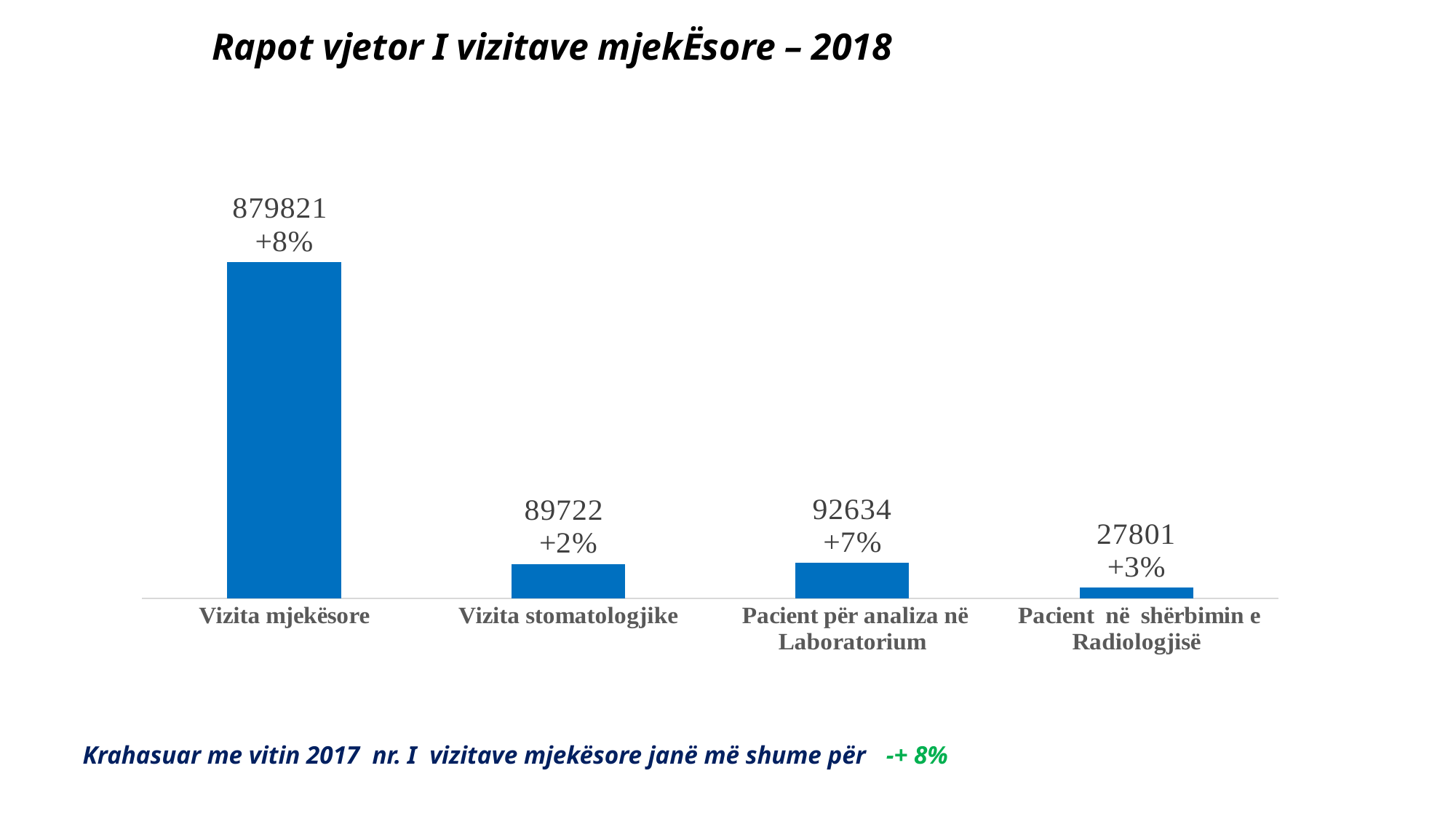
Which category has the lowest value? Pacient në shërbimin e Radiologjisë What is the value for Pacient për analiza në Laboratorium? 92634 How many categories are shown in the chart? 4 What is the value for Vizita mjekësore? 879821 What is the difference between the values for Pacient për analiza në Laboratorium and Vizita stomatologjike? 2912 What type of chart is shown on the slide? Bar chart Which category has the highest value? Vizita mjekësore What is the value for Pacient në shërbimin e Radiologjisë? 27801 What percentage change is shown above the bar for Vizita mjekësore? +8% What is the value for Vizita stomatologjike? 89722 Which is larger, the value for Pacient për analiza në Laboratorium or the value for Vizita stomatologjike? Pacient për analiza në Laboratorium What percentage change is shown above the bar for Pacient për analiza në Laboratorium? +7%